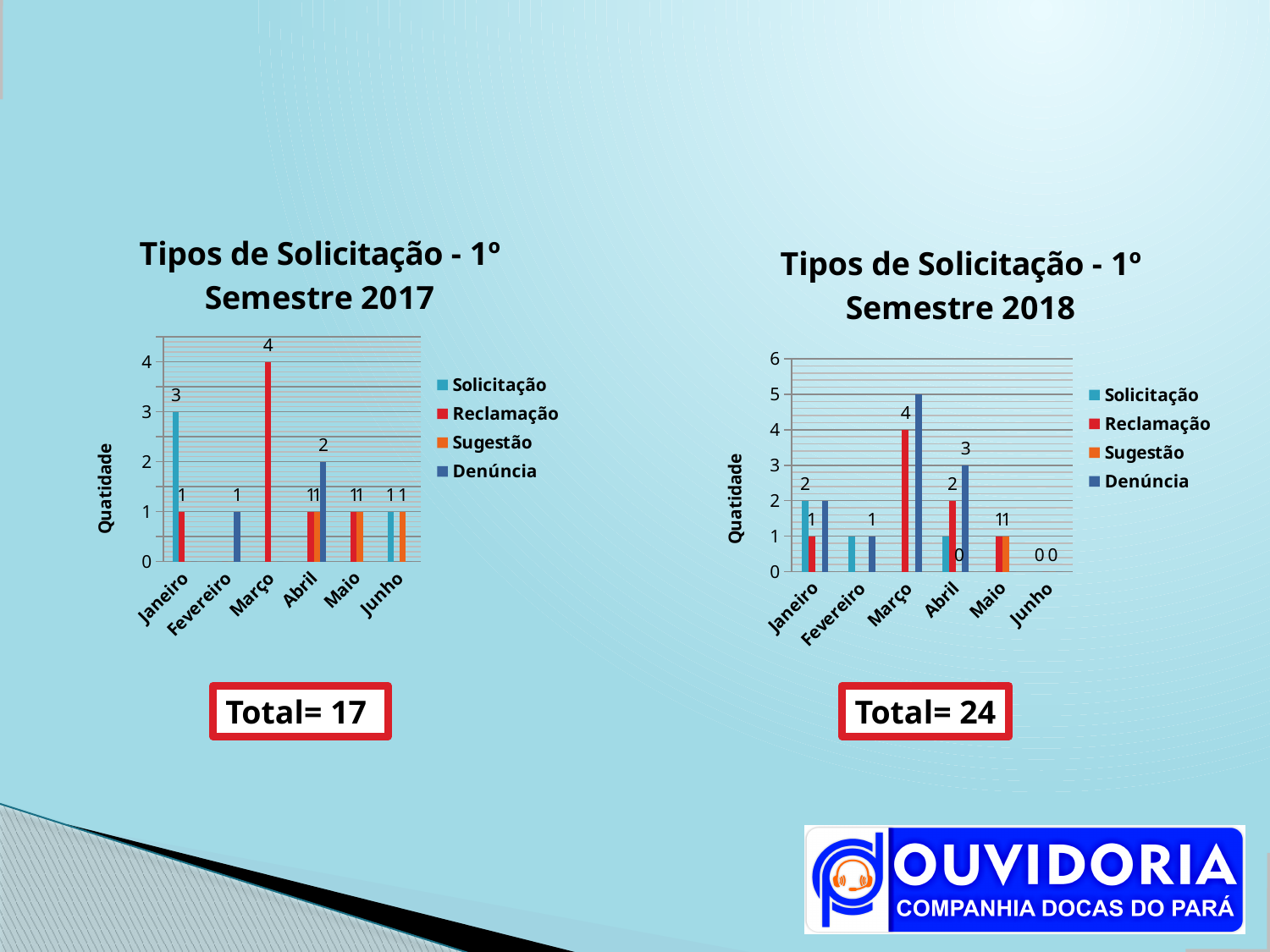
In the 'Tipos de Solicitação - 1º Semestre 2018' chart, is the value for Denúncia in Março greater or less than 4? greater In the 'Tipos de Solicitação - 1º Semestre 2017' chart, what is the value for Reclamação in Março? 4 In the 'Tipos de Solicitação - 1º Semestre 2018' chart, which is larger: Reclamação in Abril or Reclamação in Maio? Reclamação in Abril In the 'Tipos de Solicitação - 1º Semestre 2017' chart, which month has the highest single bar? Março In the 'Tipos de Solicitação - 1º Semestre 2017' chart, what is the value for Denúncia in Abril? 2 In the 'Tipos de Solicitação - 1º Semestre 2018' chart, what is the value for Denúncia in Abril? 3 How many series does the legend of the 'Tipos de Solicitação - 1º Semestre 2018' chart list? 4 In the 'Tipos de Solicitação - 1º Semestre 2017' chart, what is the difference between Reclamação in Março and Solicitação in Janeiro? 1 How many months are shown on the x axis of the 'Tipos de Solicitação - 1º Semestre 2017' chart? 6 What type of chart is 'Tipos de Solicitação - 1º Semestre 2018'? Bar chart In the 'Tipos de Solicitação - 1º Semestre 2018' chart, what is the value for Reclamação in Março? 4 In the 'Tipos de Solicitação - 1º Semestre 2017' chart, what is the value for Solicitação in Janeiro? 3